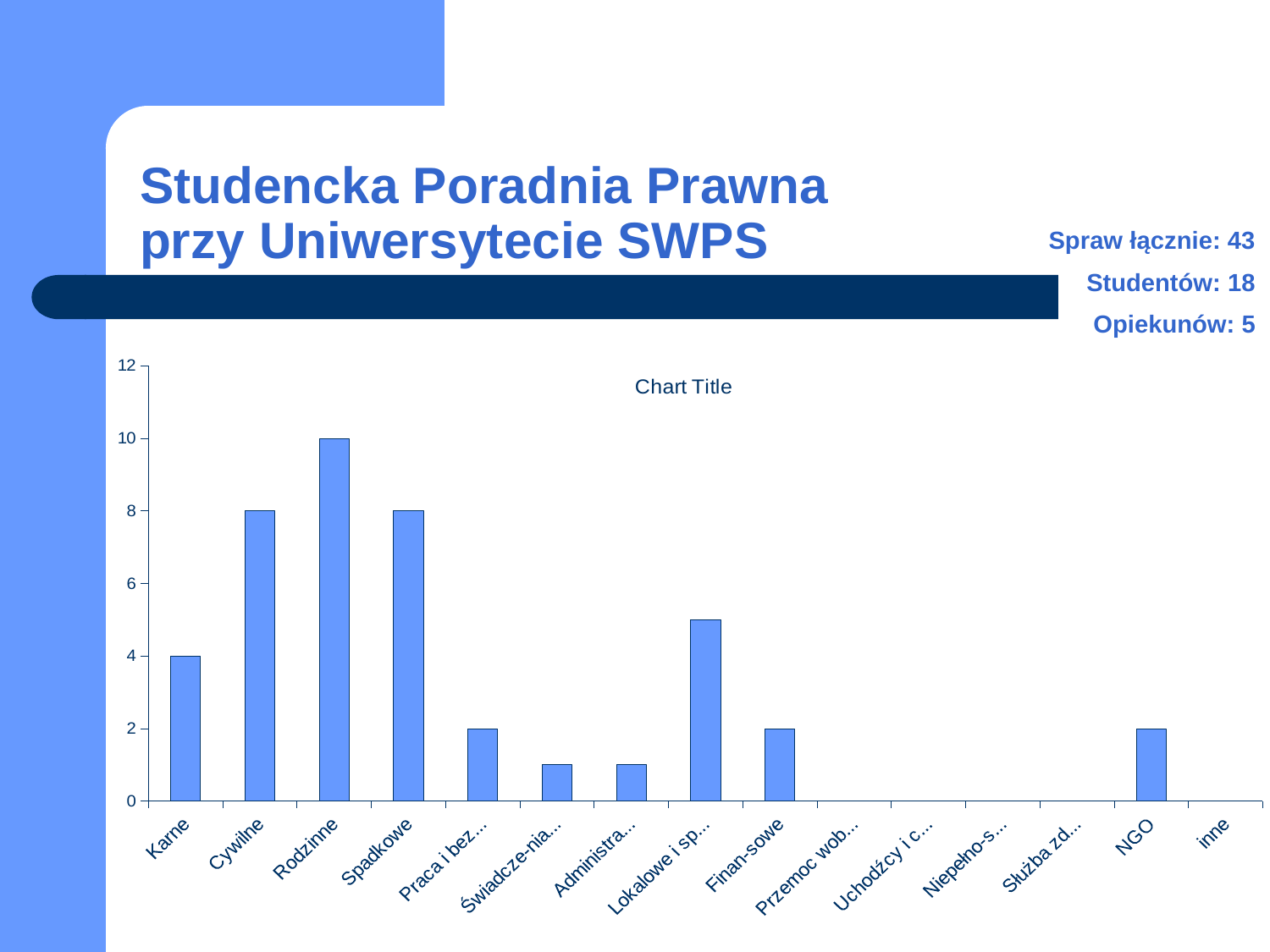
What is the value for Rodzinne? 10 What kind of chart is shown on the slide? bar chart What is the value for NGO? 2 Which category has the highest bar? Rodzinne Is the value for Administra... greater or less than 2? less Is the value for Lokalowe i sp... greater or less than 4? greater What is the difference between the values for Rodzinne and Karne? 6 Which is larger, the value for Karne or the value for Cywilne? Cywilne How many categories are shown on the x axis? 15 What is the value for Karne? 4 What is the title shown on the chart? Chart Title What is the value for Cywilne? 8